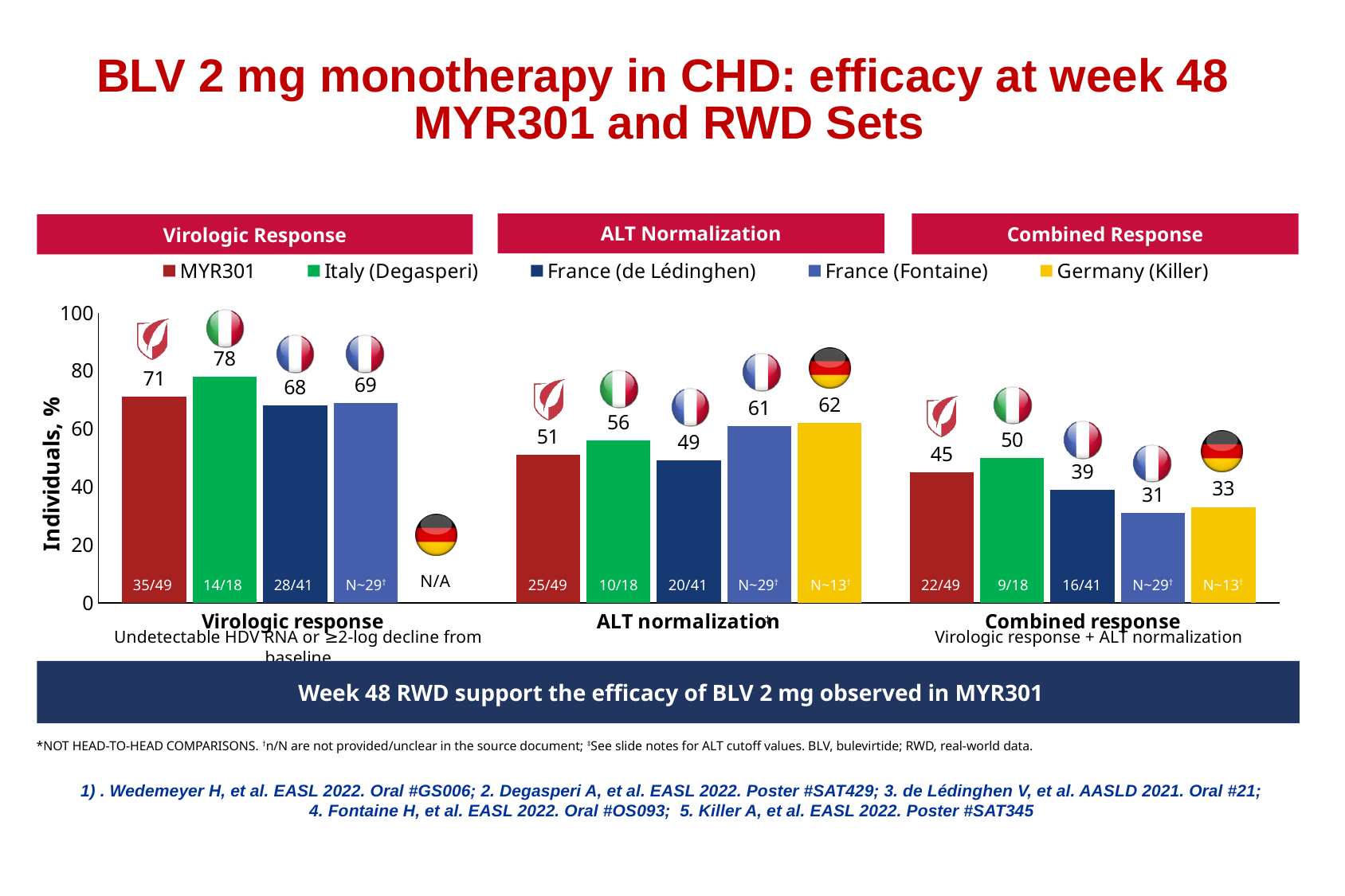
How many response categories are shown on the x axis? 3 What is the ALT normalization value for MYR301? 51 Which series has the lowest value for combined response? France (Fontaine) What is the label of the y axis? Individuals, % What kind of chart is shown on the slide? Bar chart What value is shown for Germany (Killer) in the virologic response group? N/A What is the virologic response value for Italy (Degasperi)? 78 Which series has the highest value for virologic response? Italy (Degasperi) What is the difference between the ALT normalization values for Germany (Killer) and France (de Lédinghen)? 13 For combined response, which is larger: MYR301 or Italy (Degasperi)? Italy (Degasperi) How many series does the legend list? 5 What is the combined response value for France (Fontaine)? 31